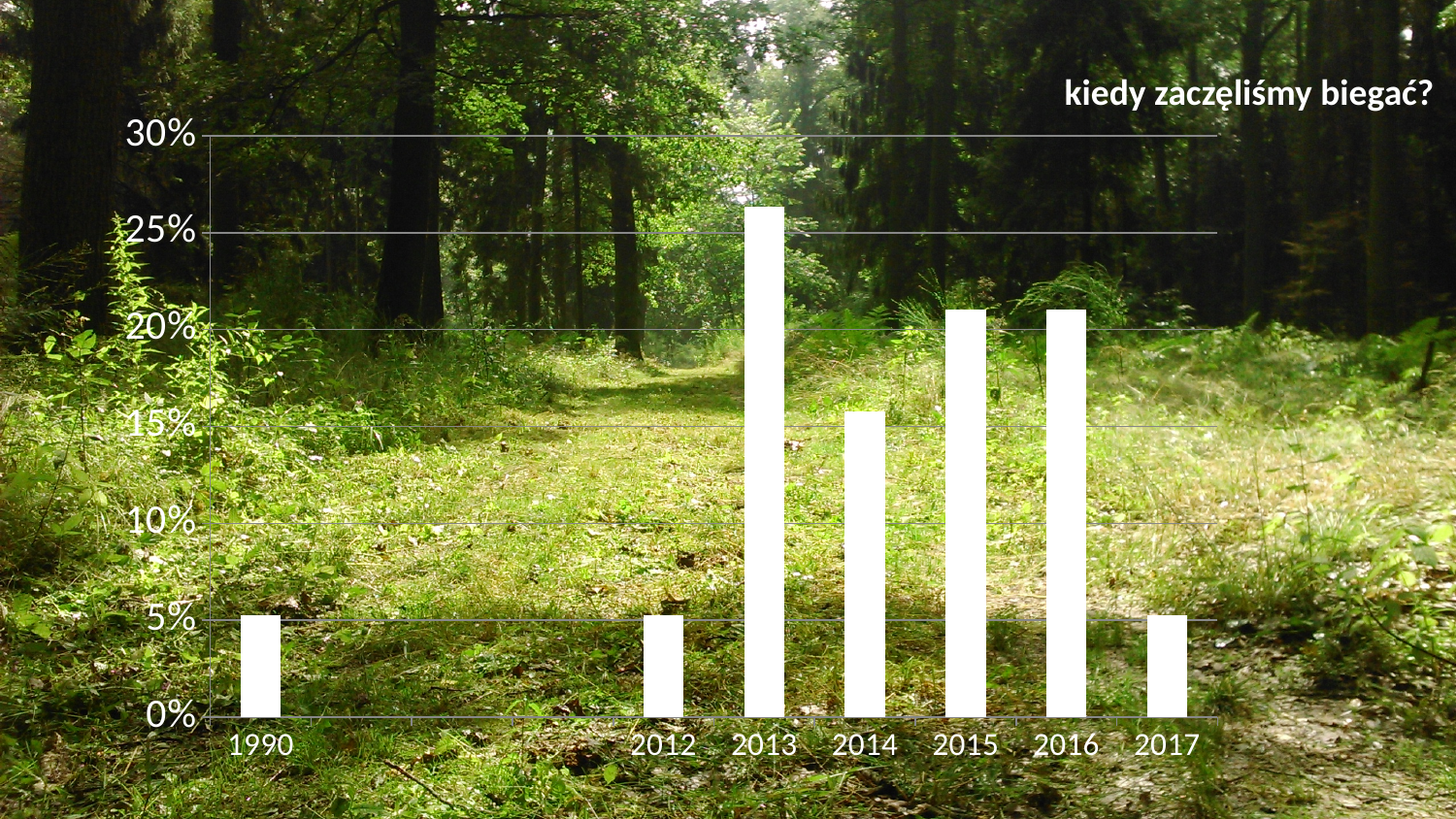
What is the title of the chart? kiedy zaczęliśmy biegać? Which year has the highest bar? 2013 Is the value for 2013 greater or less than 25%? greater Is the value for 2012 greater or less than 10%? less Which is larger, the value for 2013 or the value for 2014? 2013 Does the value rise or fall from 2012 to 2013? rise Which is larger, the value for 2014 or the value for 2015? 2015 What kind of chart is shown on the slide? bar chart How many years are shown on the x axis of the chart? 7 Is the value for 2014 greater or less than 15%? greater